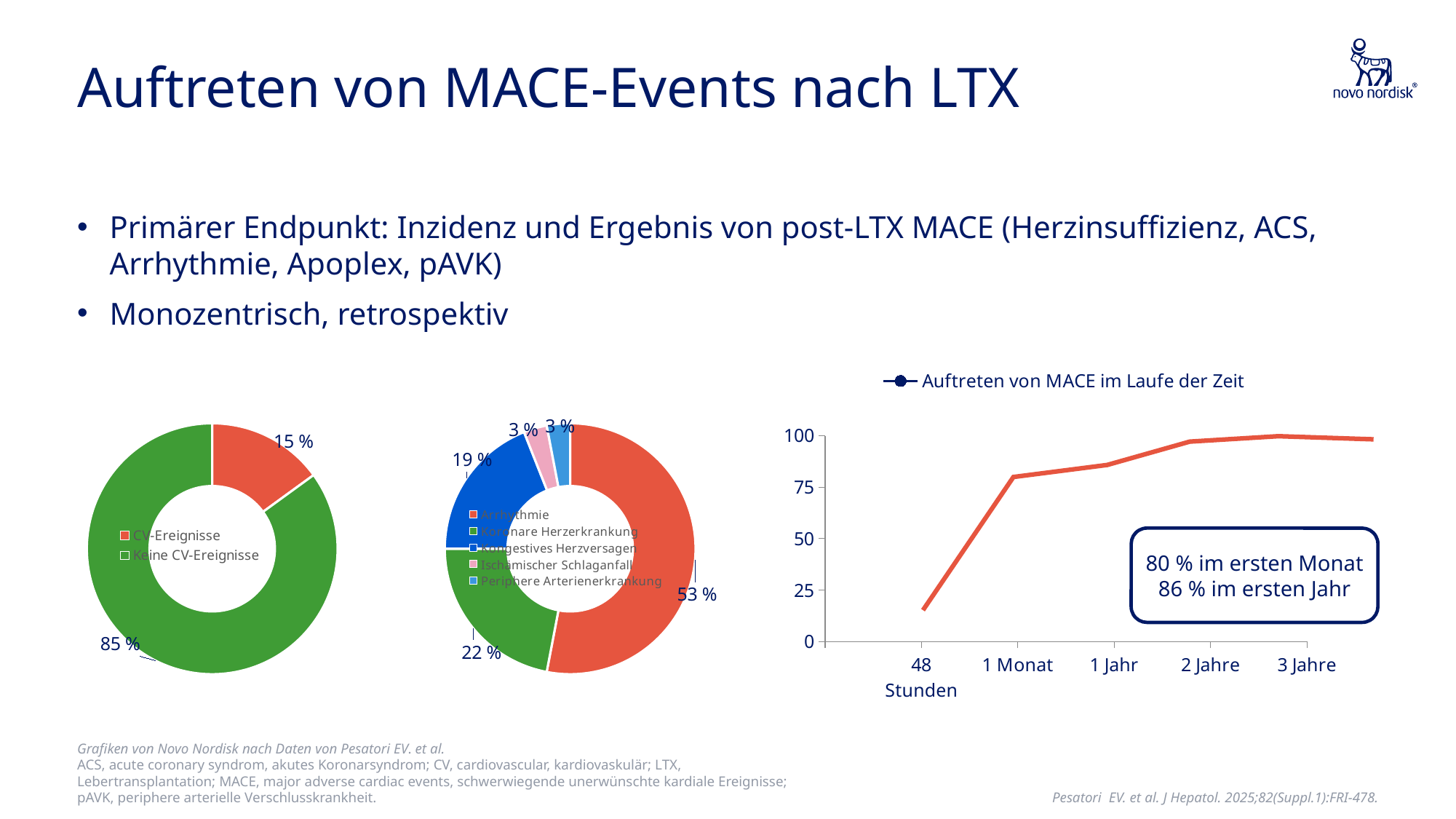
In the middle donut chart, which category has the largest share? Arrhythmie In the middle donut chart, how many categories does the legend list? 5 In the left donut chart, what percentage is shown for Keine CV-Ereignisse? 85 % In the line chart on the right, do the values rise or fall from 48 Stunden to 3 Jahre? rise In the middle donut chart, what percentage is shown for Kongestives Herzversagen? 19 % What kind of chart is the chart on the right, titled 'Auftreten von MACE im Laufe der Zeit'? Line chart In the middle donut chart, what is the difference in percentage points between Arrhythmie and Koronare Herzerkrankung? 31 In the middle donut chart, what percentage is shown for Koronare Herzerkrankung? 22 % In the left donut chart, what percentage is shown for CV-Ereignisse? 15 % In the middle donut chart, what percentage is shown for Arrhythmie? 53 % In the line chart on the right, is the value at 48 Stunden greater or less than 25? less In the left donut chart, which category has the larger share? Keine CV-Ereignisse